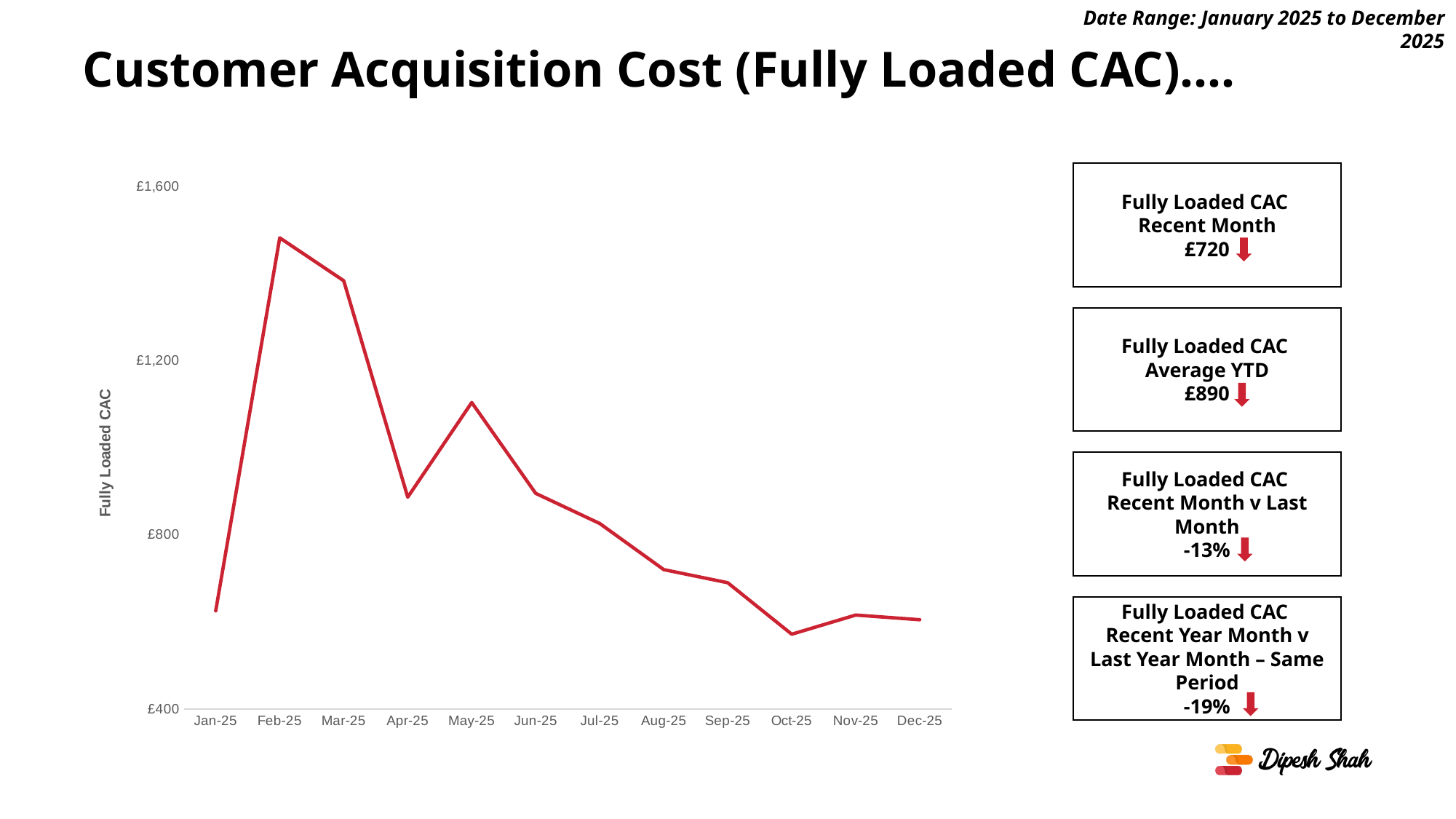
Which is larger, the value for Feb-25 or the value for Mar-25? Feb-25 What is the title of the chart's vertical axis? Fully Loaded CAC Is the value for Jan-25 greater or less than £800? less Which month has the lowest Fully Loaded CAC on the chart? Oct-25 How many months are plotted along the x axis of the chart? 12 Do the values rise or fall from May-25 to Oct-25? fall Which month has the highest Fully Loaded CAC on the chart? Feb-25 What kind of chart is shown on the slide? line chart Is the value for Oct-25 greater or less than £800? less Which is larger, the value for Apr-25 or the value for May-25? May-25 Is the value for May-25 greater or less than £1,200? less